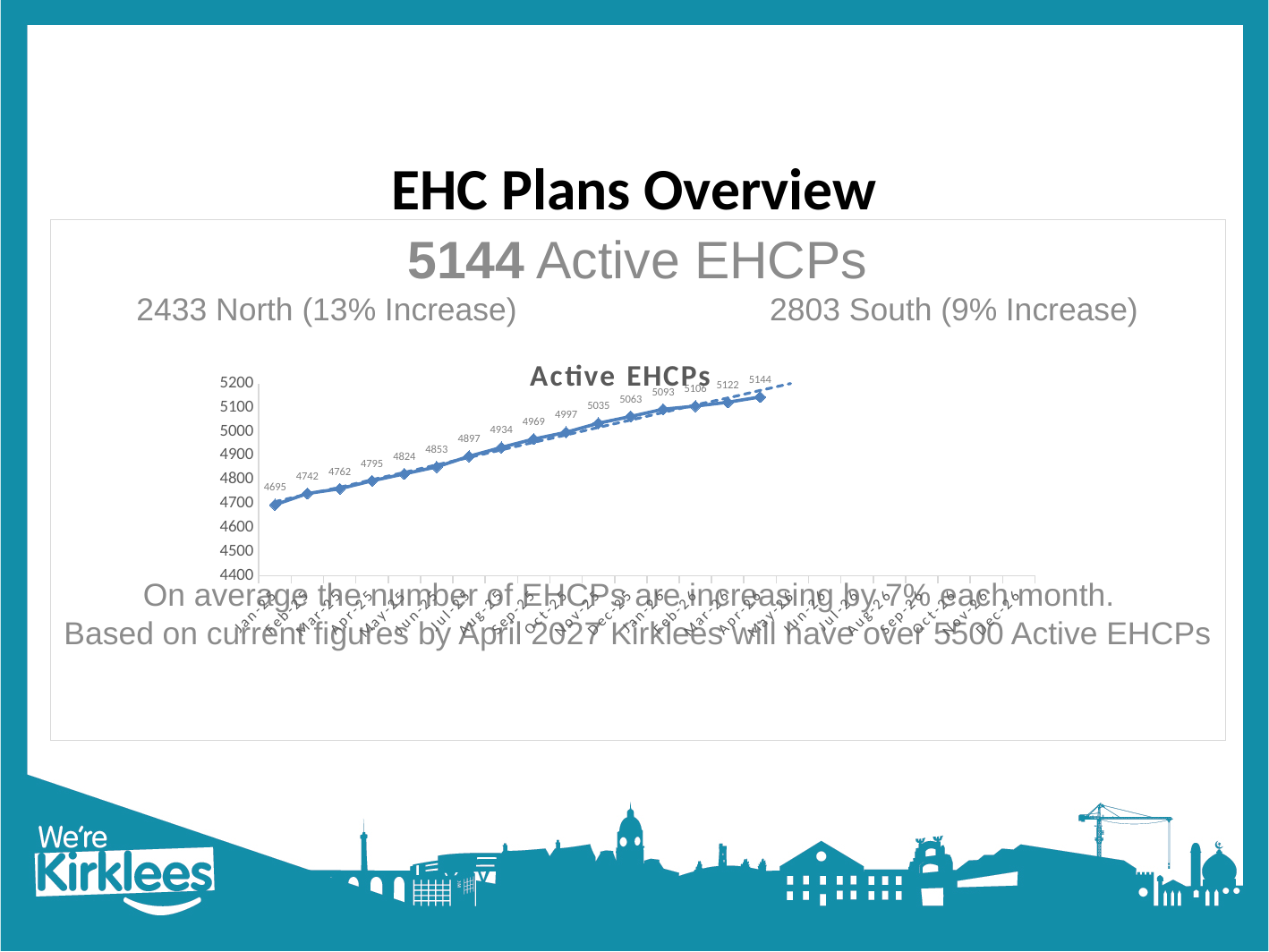
Is the first plotted value on the chart greater or less than 4700? less What is the difference between the highest and lowest values plotted on the chart? 449 What is the highest value plotted on the Active EHCPs chart? 5144 What is the lowest value plotted on the Active EHCPs chart? 4695 What is the value of the last plotted point on the chart? 5144 What kind of chart is shown on the slide? line chart What is the highest value shown on the chart's vertical axis? 5200 Do the values on the Active EHCPs chart rise or fall from left to right? rise How many data points are plotted with values on the Active EHCPs chart? 16 What is the title of the chart? Active EHCPs What is the difference between the first two plotted values, 4695 and 4742? 47 What is the value of the first plotted point on the chart? 4695